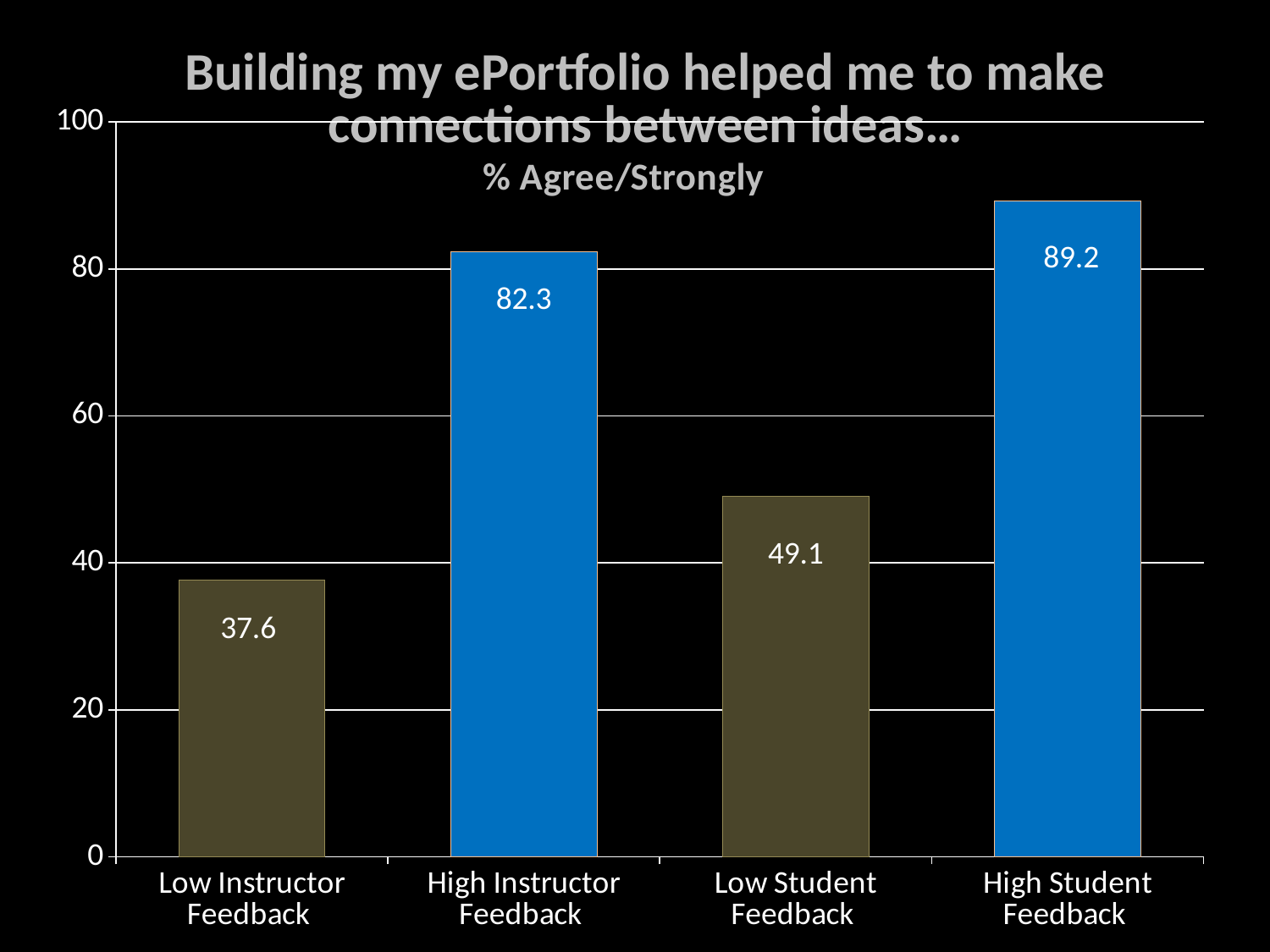
What is the difference between High Student Feedback and Low Student Feedback? 40.1 What is the value for Low Instructor Feedback? 37.6 What is the value for High Student Feedback? 89.2 What kind of chart is shown on the slide? bar chart What is the value for High Instructor Feedback? 82.3 Which is larger, Low Student Feedback or Low Instructor Feedback? Low Student Feedback What is the value for Low Student Feedback? 49.1 What is the difference between High Instructor Feedback and Low Instructor Feedback? 44.7 Is the value for Low Student Feedback greater or less than 60? less Which category has the lowest value? Low Instructor Feedback How many categories are shown on the x axis? 4 Which category has the highest value? High Student Feedback